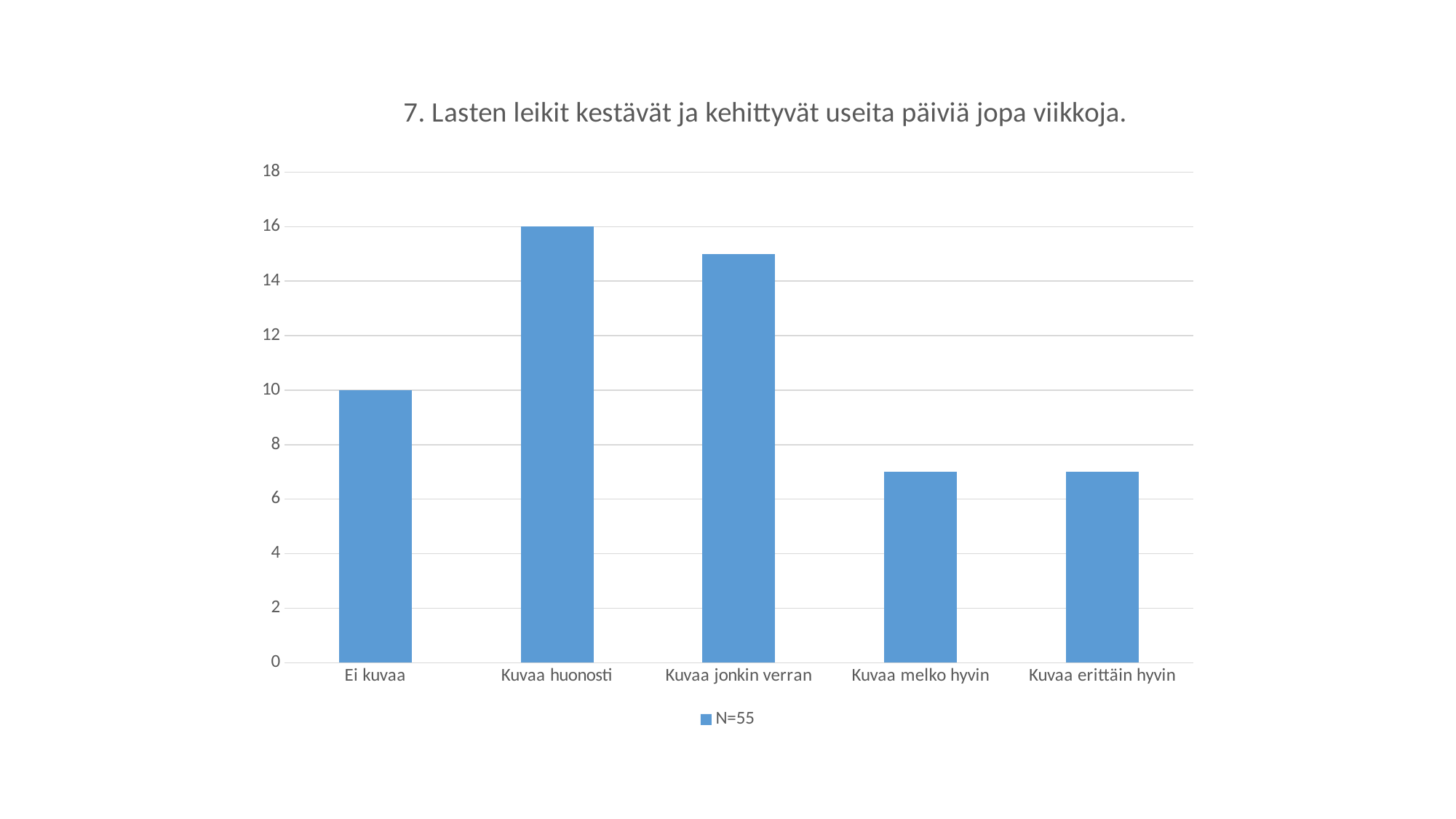
How many series does the legend list? 1 Is the value for Kuvaa melko hyvin greater or less than 8? less Is the value for Kuvaa jonkin verran greater or less than 14? greater Is the value for Kuvaa erittäin hyvin greater or less than 6? greater What is the value for Kuvaa huonosti? 16 What is the difference between the values for Kuvaa huonosti and Ei kuvaa? 6 What kind of chart is shown on the slide? bar chart Which is larger, the value for Ei kuvaa or the value for Kuvaa huonosti? Kuvaa huonosti How many categories are shown on the x axis? 5 What is the value for Ei kuvaa? 10 What is the legend entry of the chart? N=55 Which category has the highest value? Kuvaa huonosti